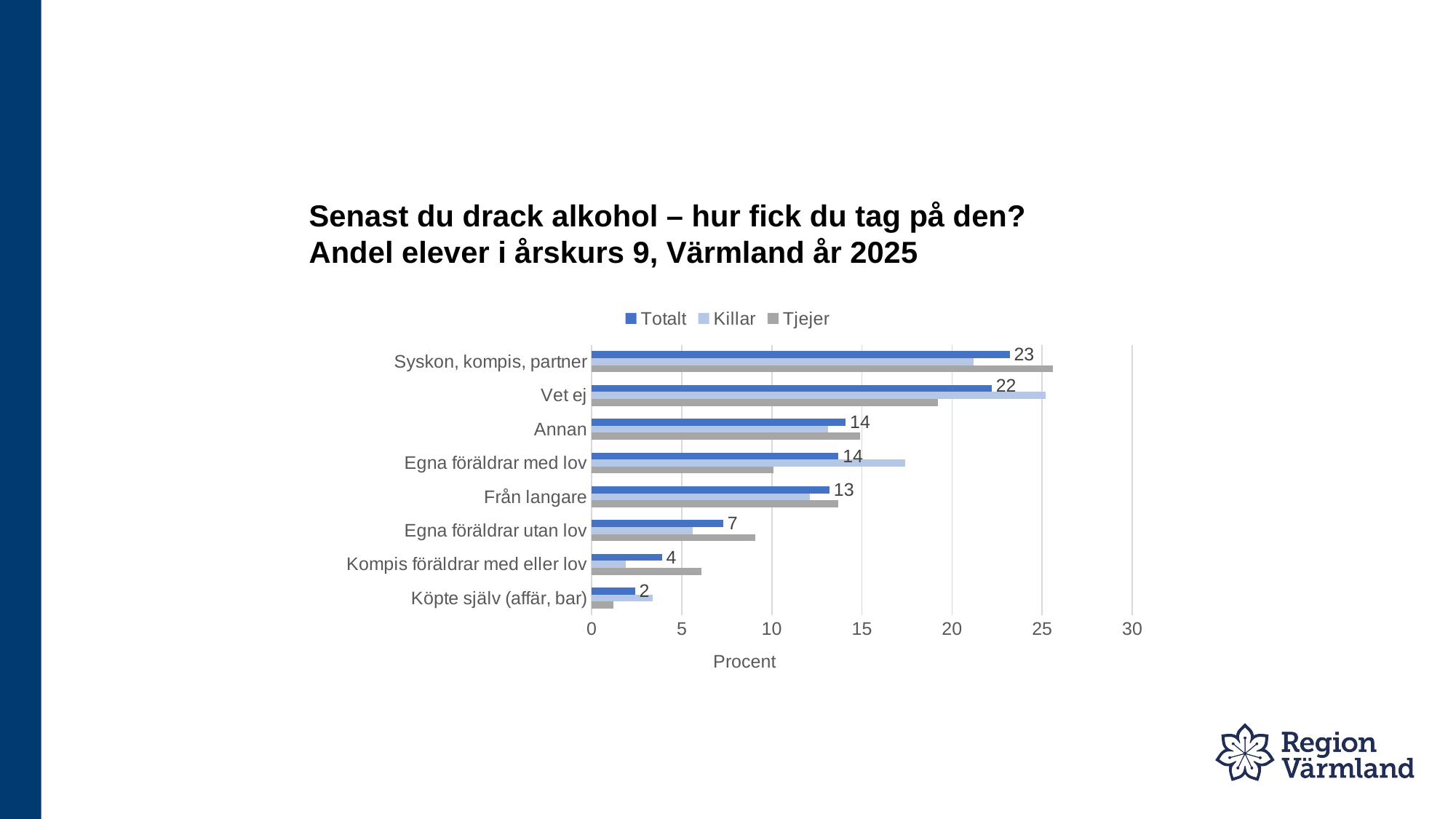
Which category has the highest Totalt value? Syskon, kompis, partner What is the Totalt value for "Från langare"? 13 What kind of chart is shown on the slide? Bar chart Which category has the lowest Totalt value? Köpte själv (affär, bar) Which has the larger Totalt value, "Från langare" or "Egna föräldrar utan lov"? Från langare Is the Killar value for "Egna föräldrar med lov" greater or less than 15? greater How many categories are shown on the y axis of the chart? 8 What is the difference between the Totalt values for "Syskon, kompis, partner" and "Köpte själv (affär, bar)"? 21 How many series does the legend list? 3 What is the Totalt value for "Vet ej"? 22 What is the Totalt value for "Kompis föräldrar med eller lov"? 4 What is the Totalt value for "Syskon, kompis, partner"? 23